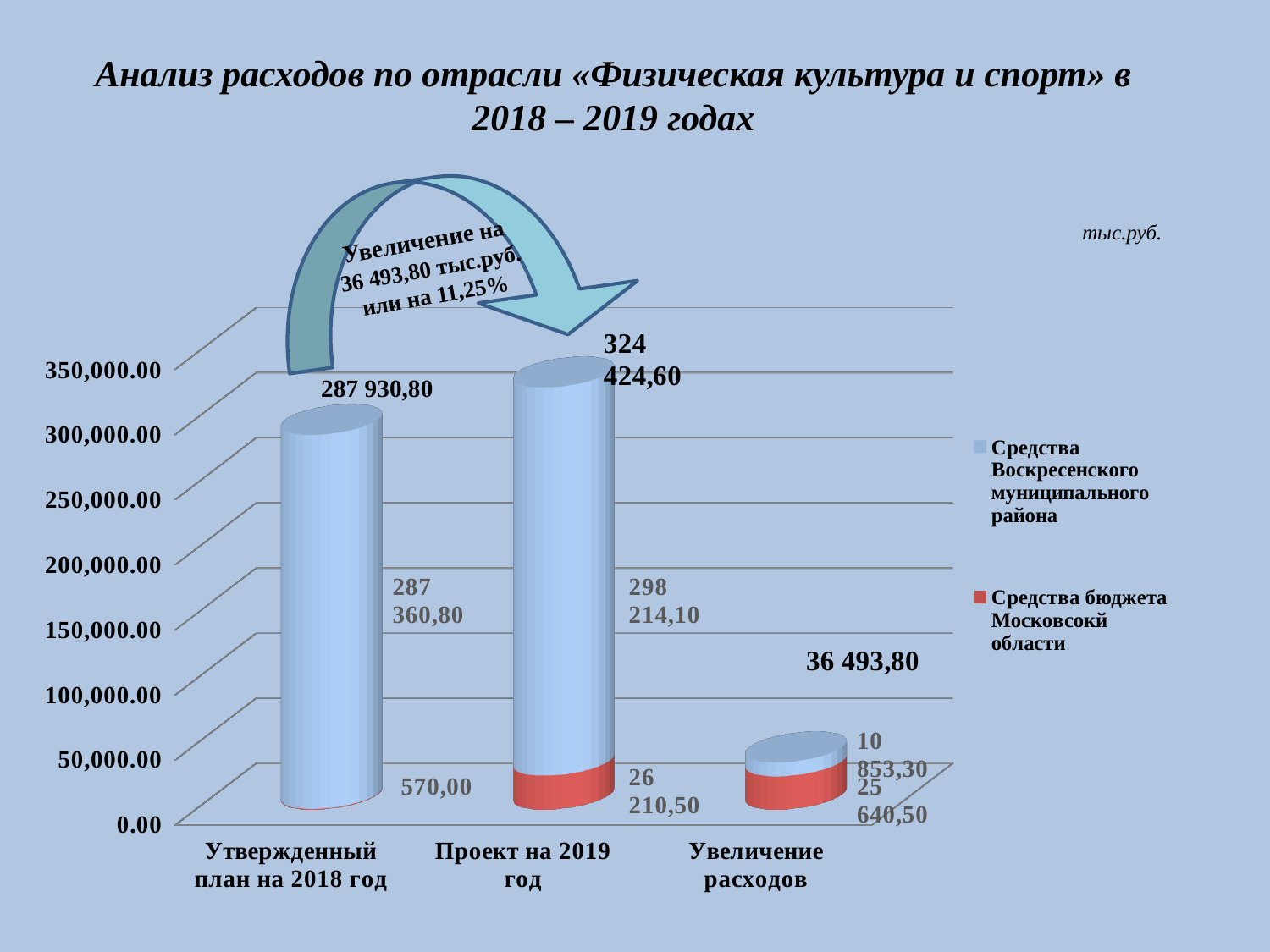
How many categories are shown on the x axis of the chart? 3 Which category has the highest total bar? Проект на 2019 год What kind of chart is shown on the slide? bar chart What is the total of the stacked bar for "Увеличение расходов"? 36 493,80 What is the total of the stacked bar for "Проект на 2019 год"? 324 424,60 Which is larger: "Средства Воскресенского муниципального района" for "Проект на 2019 год" or for "Утвержденный план на 2018 год"? Проект на 2019 год What is the value of "Средства бюджета Московсокй области" for "Проект на 2019 год"? 26 210,50 Which category has the lowest total bar? Увеличение расходов What is the value of "Средства Воскресенского муниципального района" for "Утвержденный план на 2018 год"? 287 360,80 What is the value of "Средства Воскресенского муниципального района" for "Увеличение расходов"? 10 853,30 How many series does the chart legend list? 2 What is the value of "Средства бюджета Московсокй области" for "Утвержденный план на 2018 год"? 570,00